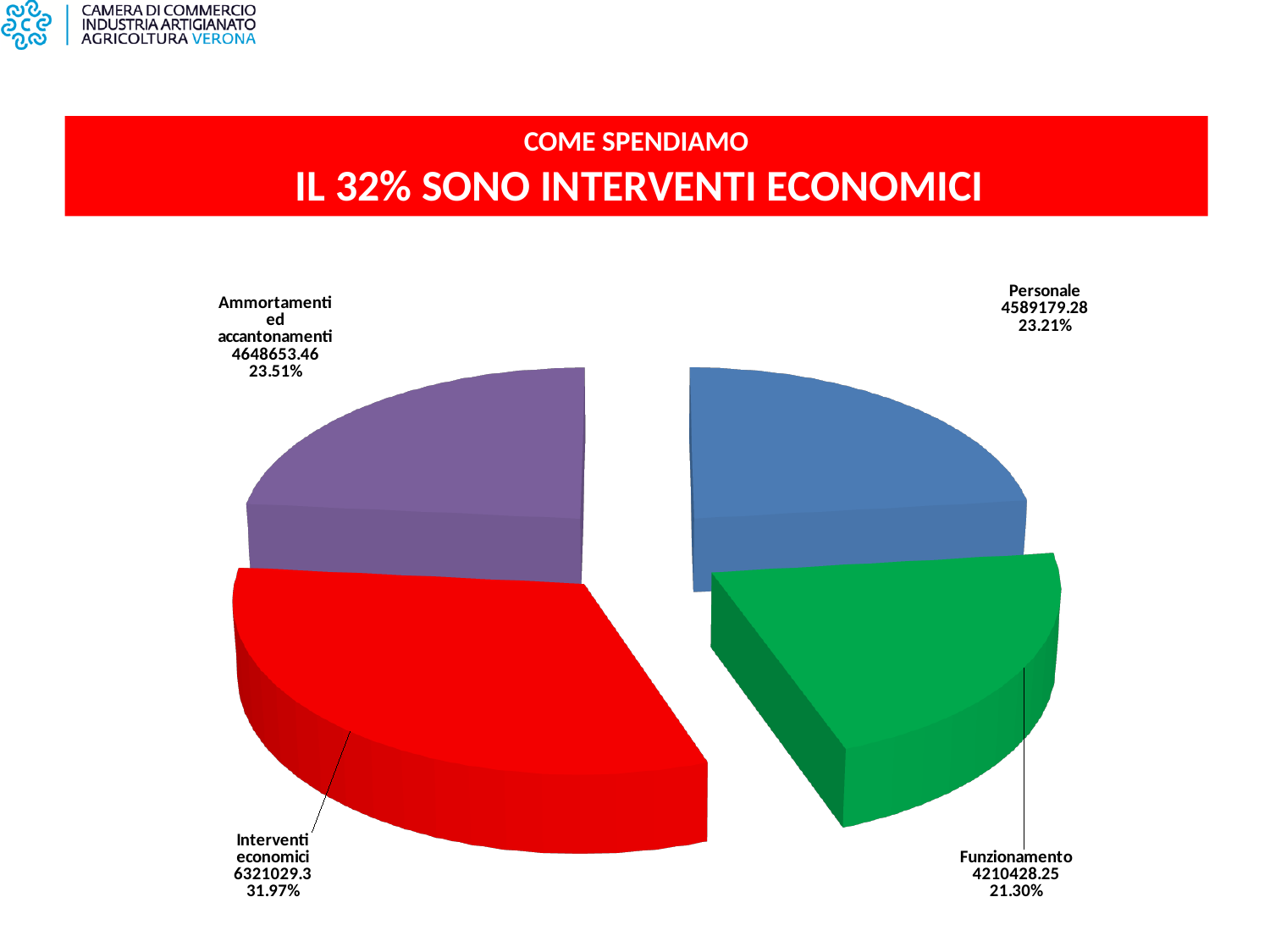
What colour is the Interventi economici slice? red How many slices does the pie chart have? 4 What kind of chart is shown on the slide? pie chart Which is larger, the value for Ammortamenti ed accantonamenti or the value for Personale? Ammortamenti ed accantonamenti What is the value shown for Interventi economici? 6321029.3 Which category has the largest slice of the pie? Interventi economici What is the difference between the value for Interventi economici and the value for Personale? 1731850.02 What percentage share does Funzionamento have? 21.30% What is the value shown for Personale? 4589179.28 What is the difference in percentage points between the share of Interventi economici and the share of Funzionamento? 10.67 Which category has the smallest slice of the pie? Funzionamento What percentage share does Ammortamenti ed accantonamenti have? 23.51%